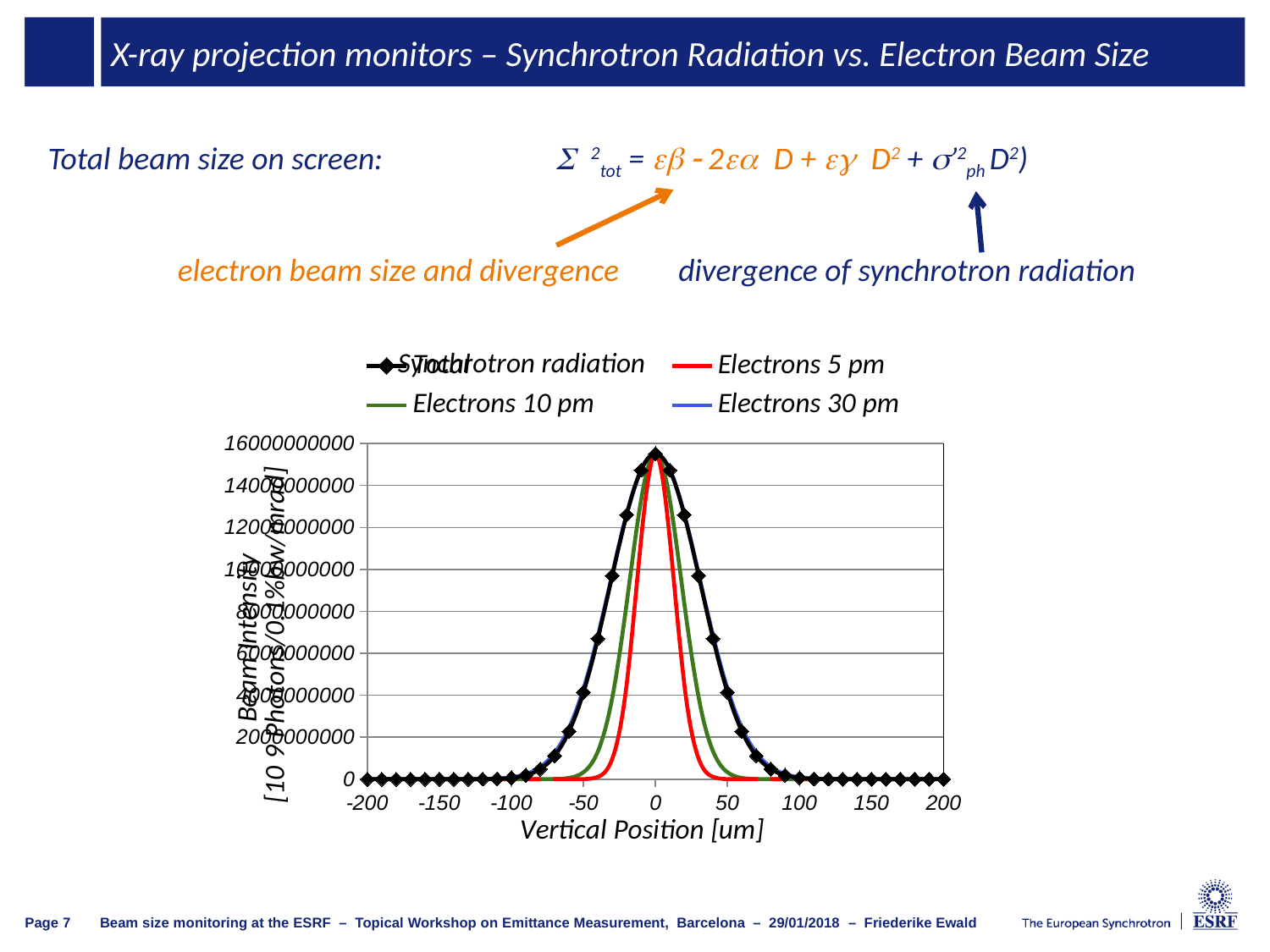
What kind of chart is shown on the slide? line chart Which series has the wider peak, 'Electrons 10 pm' or 'Electrons 30 pm'? Electrons 30 pm Do the curves rise or fall as the vertical position goes from -200 to 0? rise At which vertical position do all the curves reach their peak? 0 Which series has the narrowest peak, 'Electrons 5 pm' or 'Electrons 10 pm'? Electrons 5 pm What colour is the line for the 'Electrons 5 pm' series? red Is the peak value of the curves at vertical position 0 greater or less than 16000000000? less Is the peak value of the curves at vertical position 0 greater or less than 14000000000? greater What is the label of the x axis of the chart? Vertical Position [um] Do the curves rise or fall as the vertical position goes from 0 to 200? fall Is the value of the 'Electrons 5 pm' series at vertical position 50 greater or less than 2000000000? less